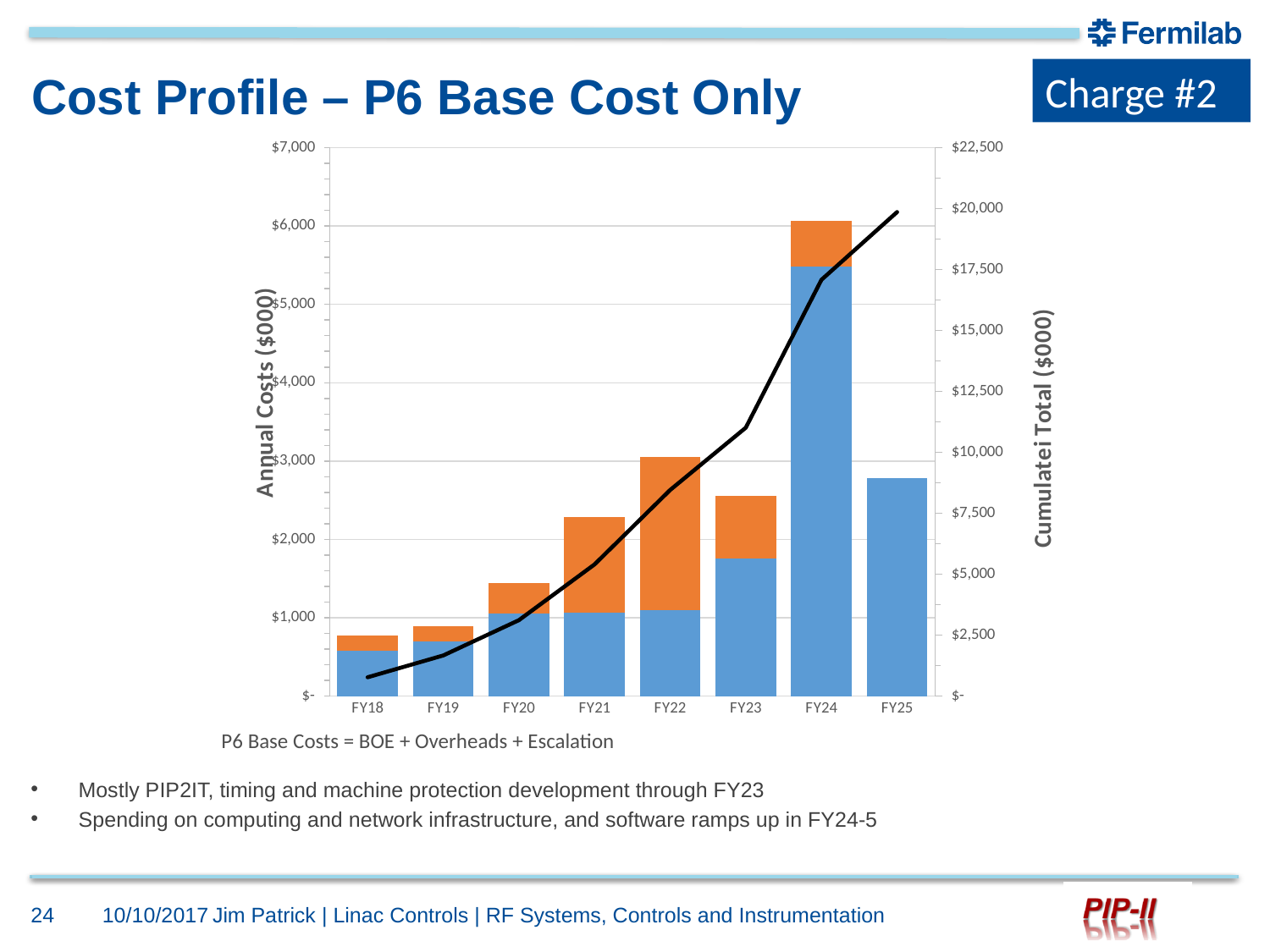
How many fiscal years are shown on the x axis of the chart? 8 Which has the larger total annual cost bar, FY24 or FY25? FY24 What kind of chart is used to show the annual costs? Stacked bar chart with a line for the cumulative total What is the title of the right-hand vertical axis? Cumulatei Total ($000) Which fiscal year has the tallest annual cost bar? FY24 Is the cumulative total line at FY23 greater or less than $10,000? greater Which fiscal year has the shortest annual cost bar? FY18 Is the total annual cost bar for FY18 greater or less than $1,000? less Is the total annual cost bar for FY25 greater or less than $3,000? less Does the cumulative total line rise or fall from FY18 to FY25? rises